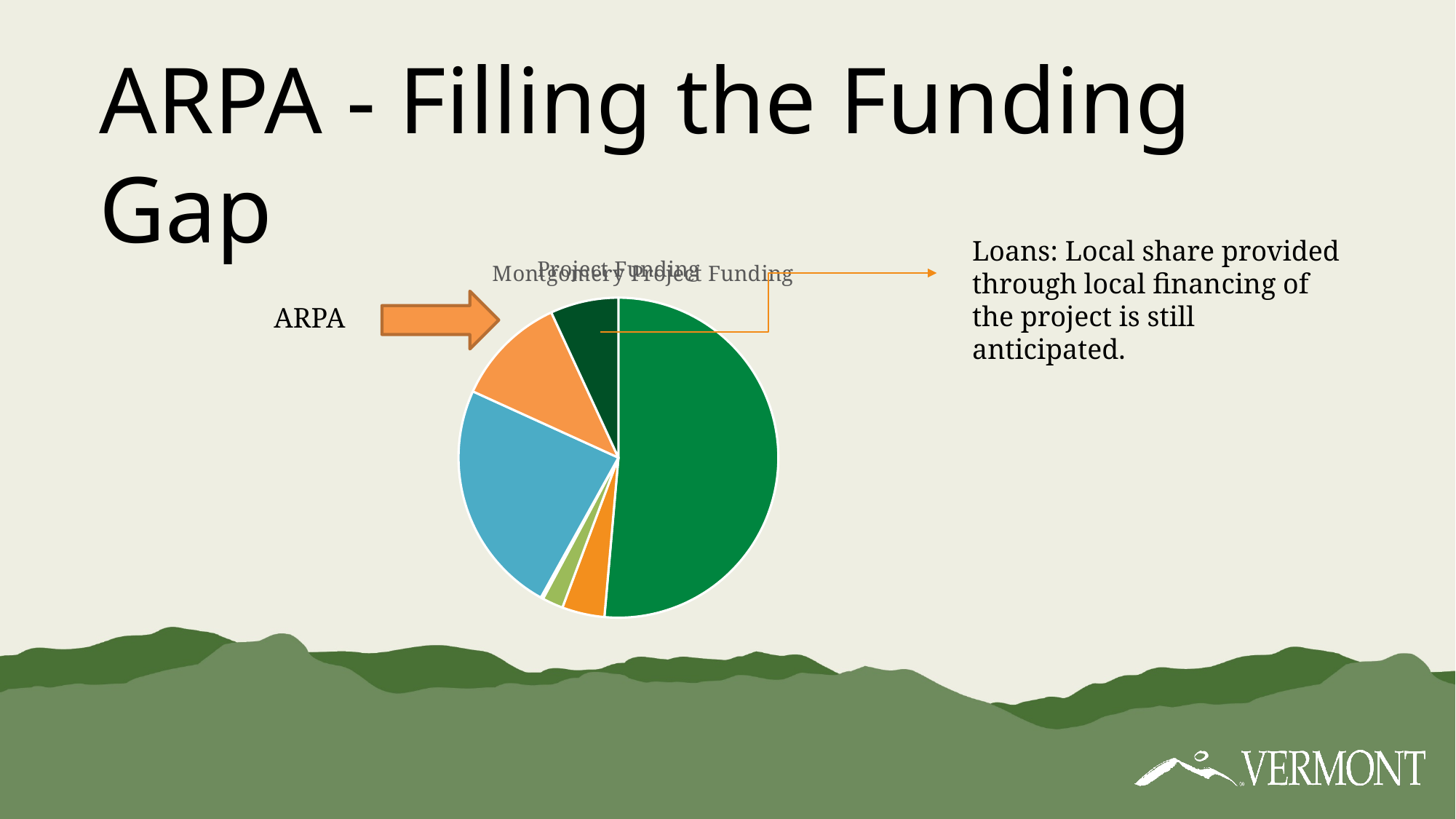
Is the ARPA slice more or less than half of the pie? Less Which slice of the pie chart is labelled with the arrow marked "ARPA"? The orange slice Which slice of the pie chart does the "Loans" annotation point to? The dark green slice Does the pie chart show a legend? No Which colour slice is the largest in the pie chart? Green How many slices does the pie chart have? 7 What kind of chart is shown on the slide? Pie chart Is the ARPA slice larger or smaller than the blue slice? Smaller Is the ARPA slice larger or smaller than the light green slice? Larger